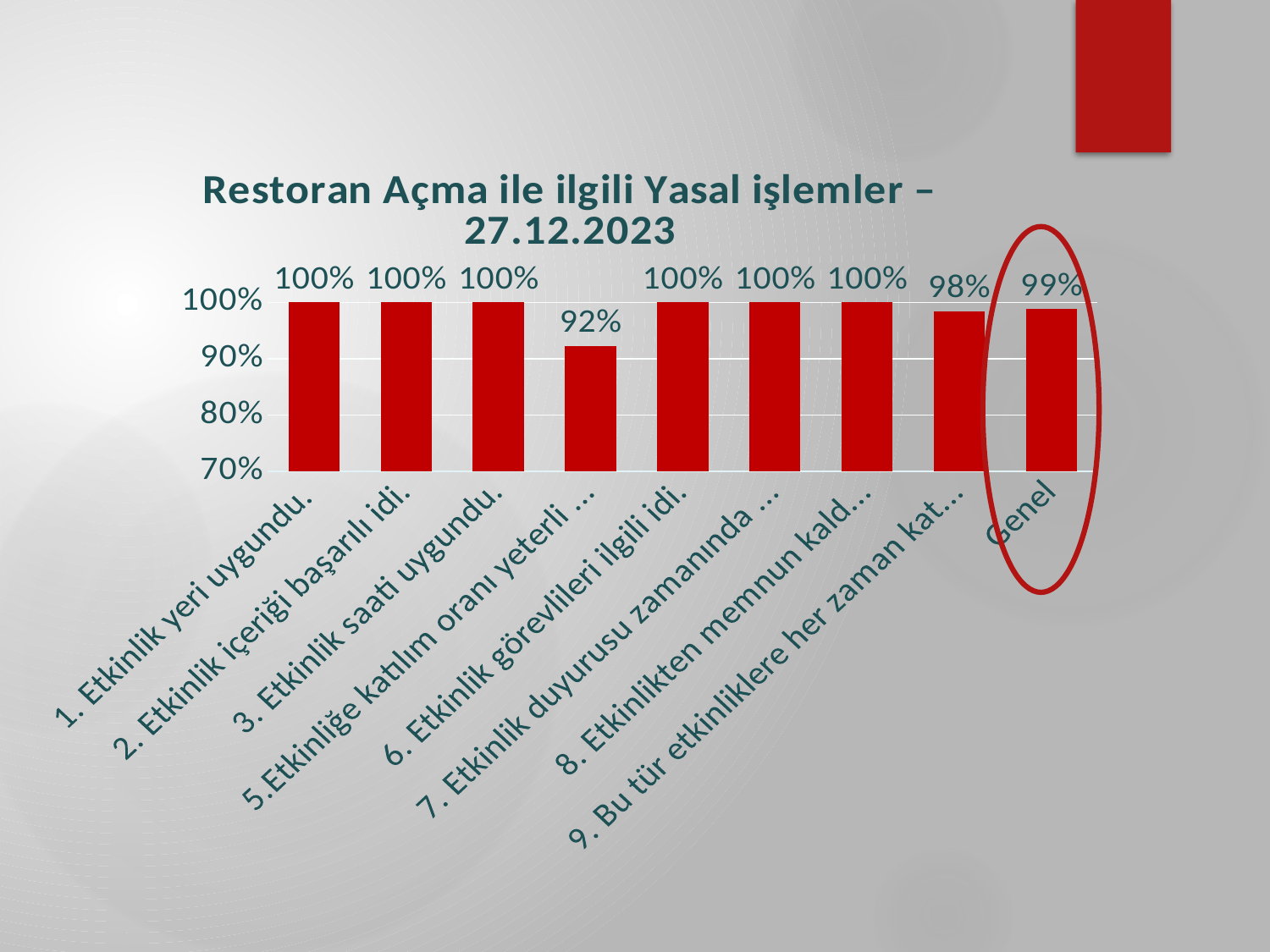
Which is larger: the value for "Genel" or the value for "5.Etkinliğe katılım oranı yeterli …"? Genel Is the value for "5.Etkinliğe katılım oranı yeterli …" greater or less than 90%? greater What is the title of the chart? Restoran Açma ile ilgili Yasal işlemler – 27.12.2023 What is the value for "1. Etkinlik yeri uygundu."? 100% Which category has the lowest value? 5.Etkinliğe katılım oranı yeterli … What is the value for "3. Etkinlik saati uygundu."? 100% What is the difference between the value for "Genel" and the lowest bar (92%)? 7% What kind of chart is shown on the slide? Bar chart How many bars are shown in the chart? 9 What is the value for "Genel"? 99% What is the value for "6. Etkinlik görevlileri ilgili idi."? 100% What is the difference between the value for "1. Etkinlik yeri uygundu." and the value for "Genel"? 1%